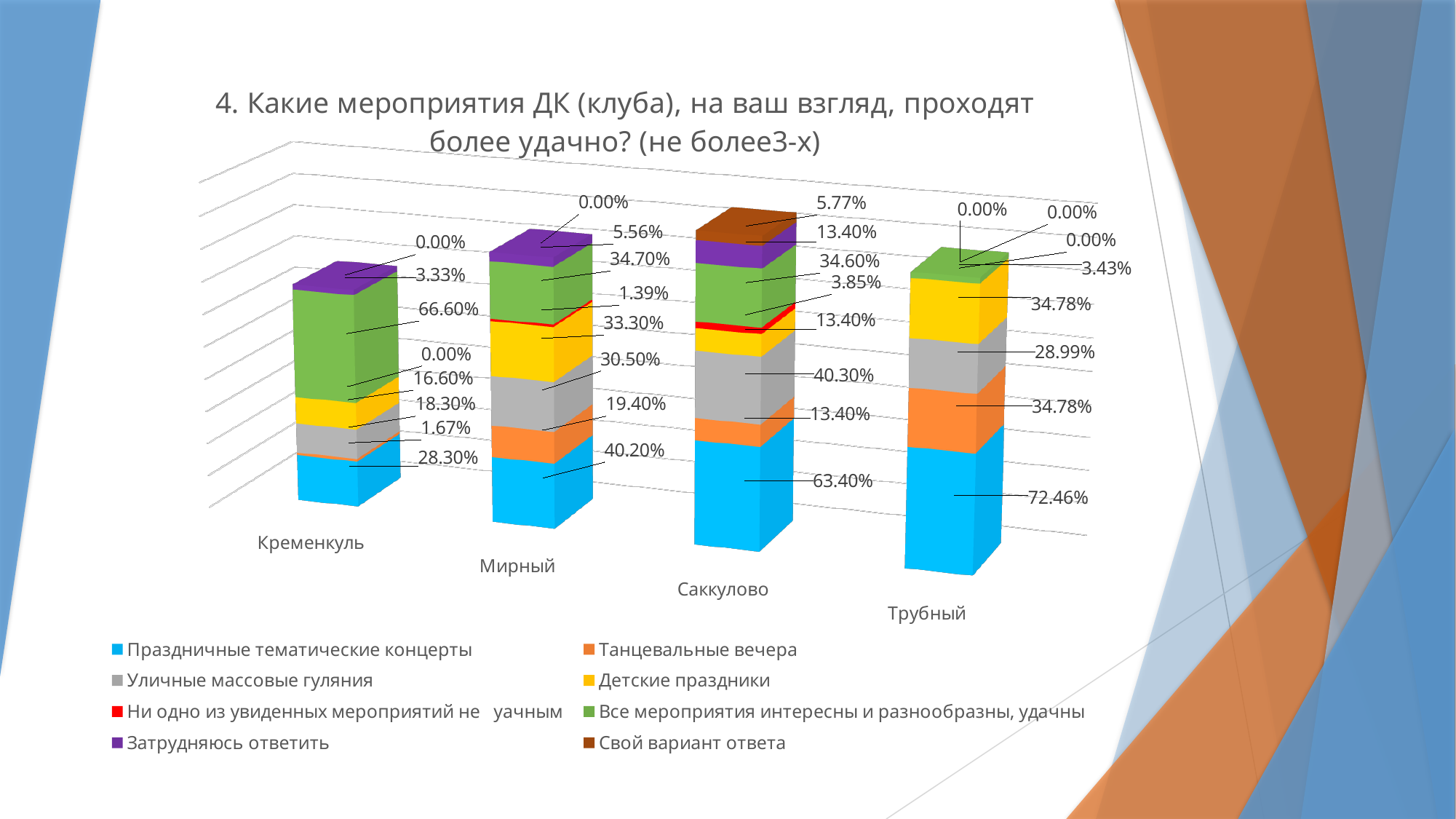
What is the value for Уличные массовые гуляния in Саккулово? 40.30% Which settlement has a non-zero value for Свой вариант ответа? Саккулово What type of chart is shown on the slide? Stacked bar chart What is the value for Детские праздники in Мирный? 33.30% Which is larger: the Танцевальные вечера value for Трубный or for Мирный? Трубный How many categories (settlements) are shown on the x axis? 4 What is the value for Праздничные тематические концерты in Трубный? 72.46% Which settlement has the highest value for Праздничные тематические концерты? Трубный How many series does the legend list? 8 What is the difference between the Праздничные тематические концерты values for Саккулово and Мирный? 23.20% Which settlement has the lowest value for Праздничные тематические концерты? Кременкуль What is the value for Все мероприятия интересны и разнообразны, удачны in Кременкуль? 66.60%